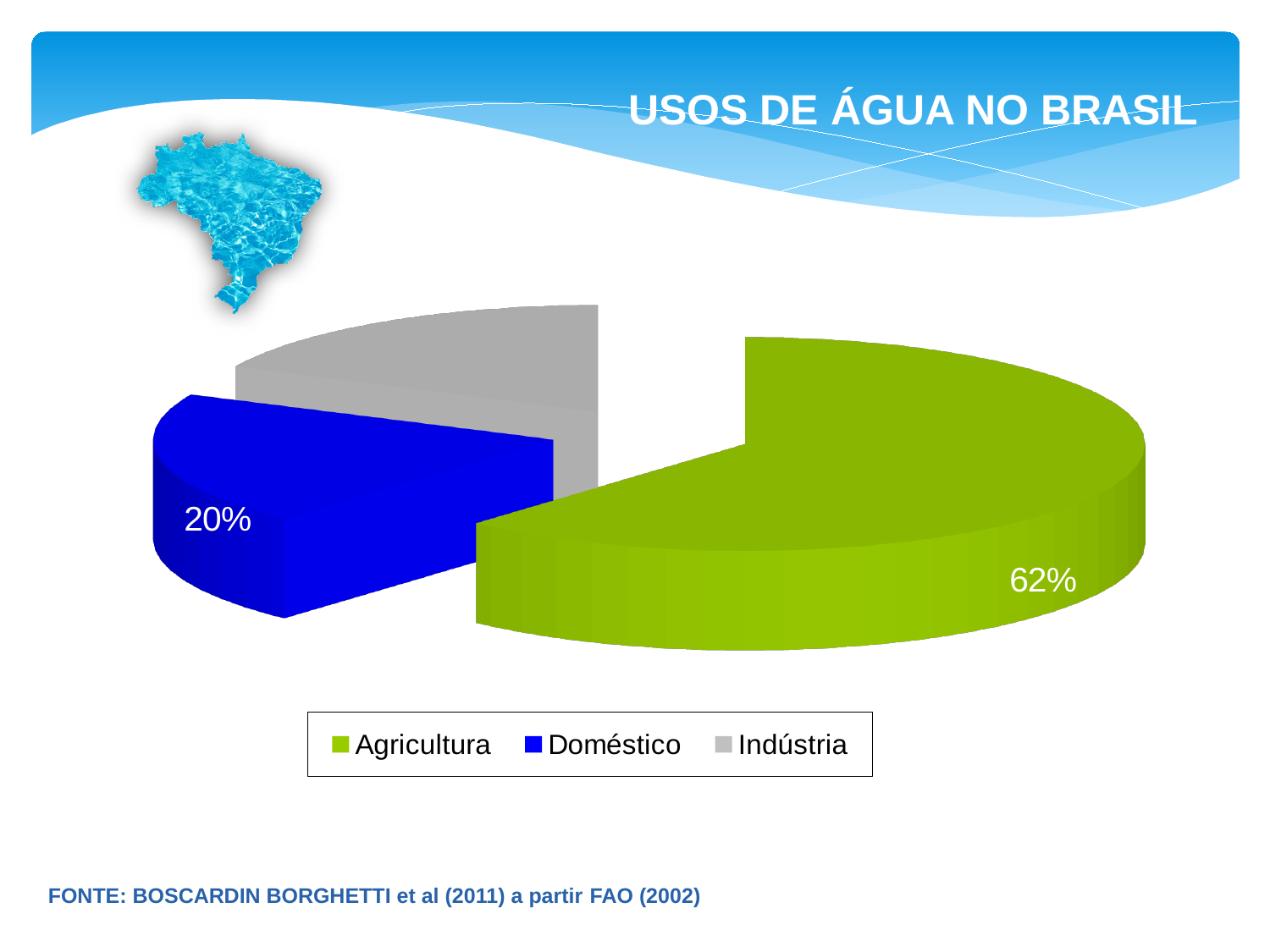
What is the difference in percentage points between the Agricultura and Doméstico slices? 42 percentage points How many categories are shown in the pie chart? 3 Is the Agricultura slice greater or less than 50% of the pie? greater Which colour represents Indústria in the legend? Grey Which category accounts for the largest share of water use in the pie chart? Agricultura Which slice is larger, Agricultura or Indústria? Agricultura What percentage of water use in Brazil is for Agricultura? 62% What percentage of water use in Brazil is for Doméstico? 20% What is the title of the chart on the slide? USOS DE ÁGUA NO BRASIL What share of the pie does the Agricultura slice represent? 62% Which slice is larger, Agricultura or Doméstico? Agricultura What kind of chart is shown on the slide? Pie chart